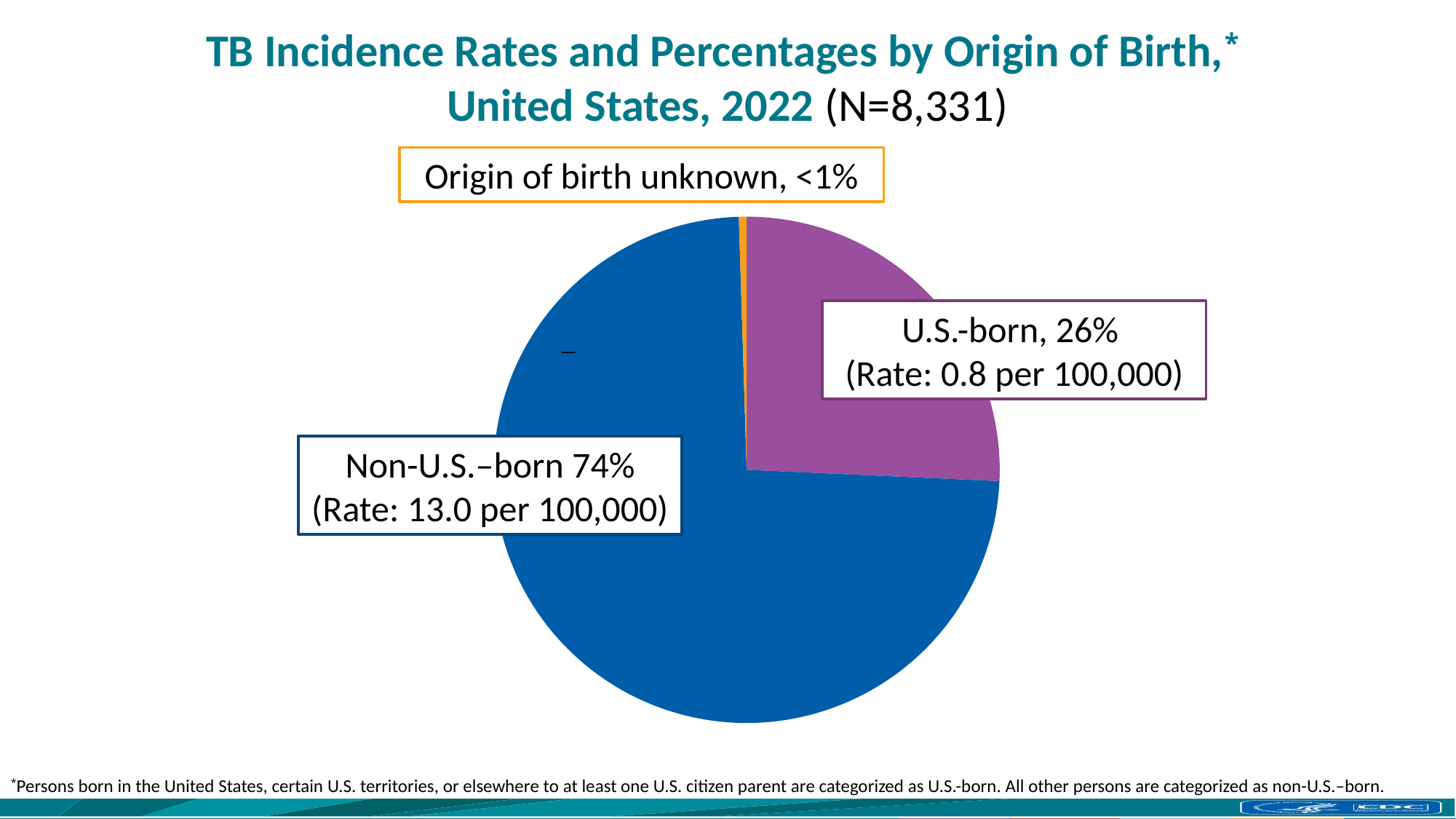
What percentage of cases have an unknown origin of birth? <1% What kind of chart is shown on the slide? pie chart Which origin-of-birth category has the largest share of the pie? Non-U.S.-born What is the difference in percentage points between the non-U.S.-born and U.S.-born shares? 48 How many slices does the pie chart have? 3 What is the TB incidence rate for U.S.-born persons? 0.8 per 100,000 Which origin-of-birth category has the smallest share of the pie? Origin of birth unknown What percentage of TB cases is attributed to U.S.-born persons? 26% Which is larger, the share for U.S.-born or the share for non-U.S.-born? Non-U.S.-born What percentage of TB cases is attributed to non-U.S.-born persons? 74% What is the TB incidence rate for non-U.S.-born persons? 13.0 per 100,000 What is the total number of cases (N) given in the chart title? 8,331